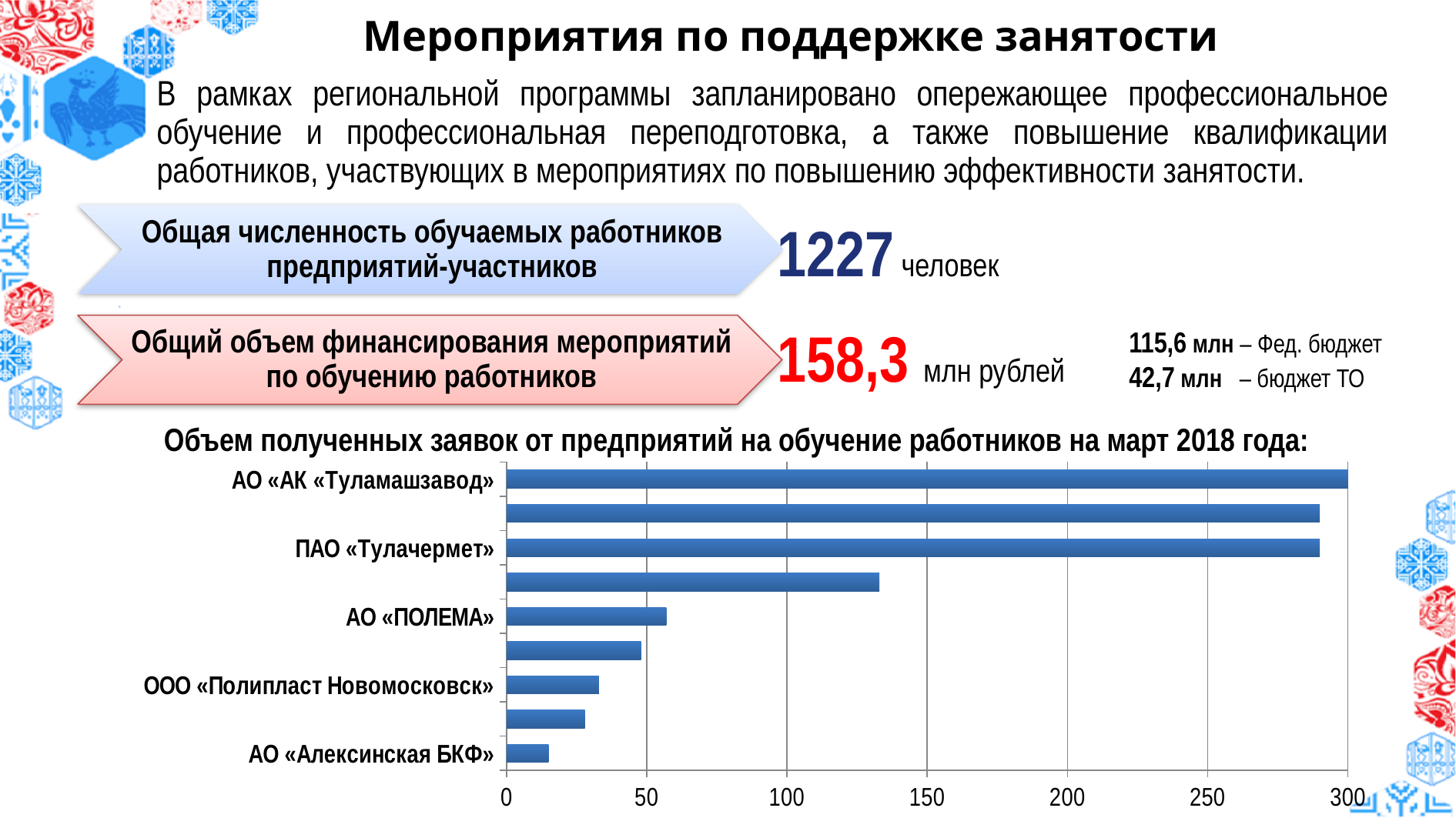
Which has a larger value, АО «ПОЛЕМА» or ООО «Полипласт Новомосковск»? АО «ПОЛЕМА» Is the value for ПАО «Тулачермет» greater or less than 200? greater Which labelled company has the highest value in the chart? АО «АК «Туламашзавод» What kind of chart is shown on the slide? bar chart Is the value for АО «Алексинская БКФ» greater or less than 50? less How many bars are plotted in the chart? 9 What is the title of the chart? Объем полученных заявок от предприятий на обучение работников на март 2018 года Is the value for ООО «Полипласт Новомосковск» greater or less than 50? less Do the bar values increase or decrease going from the top of the chart to the bottom? decrease Which labelled company has the lowest value in the chart? АО «Алексинская БКФ»